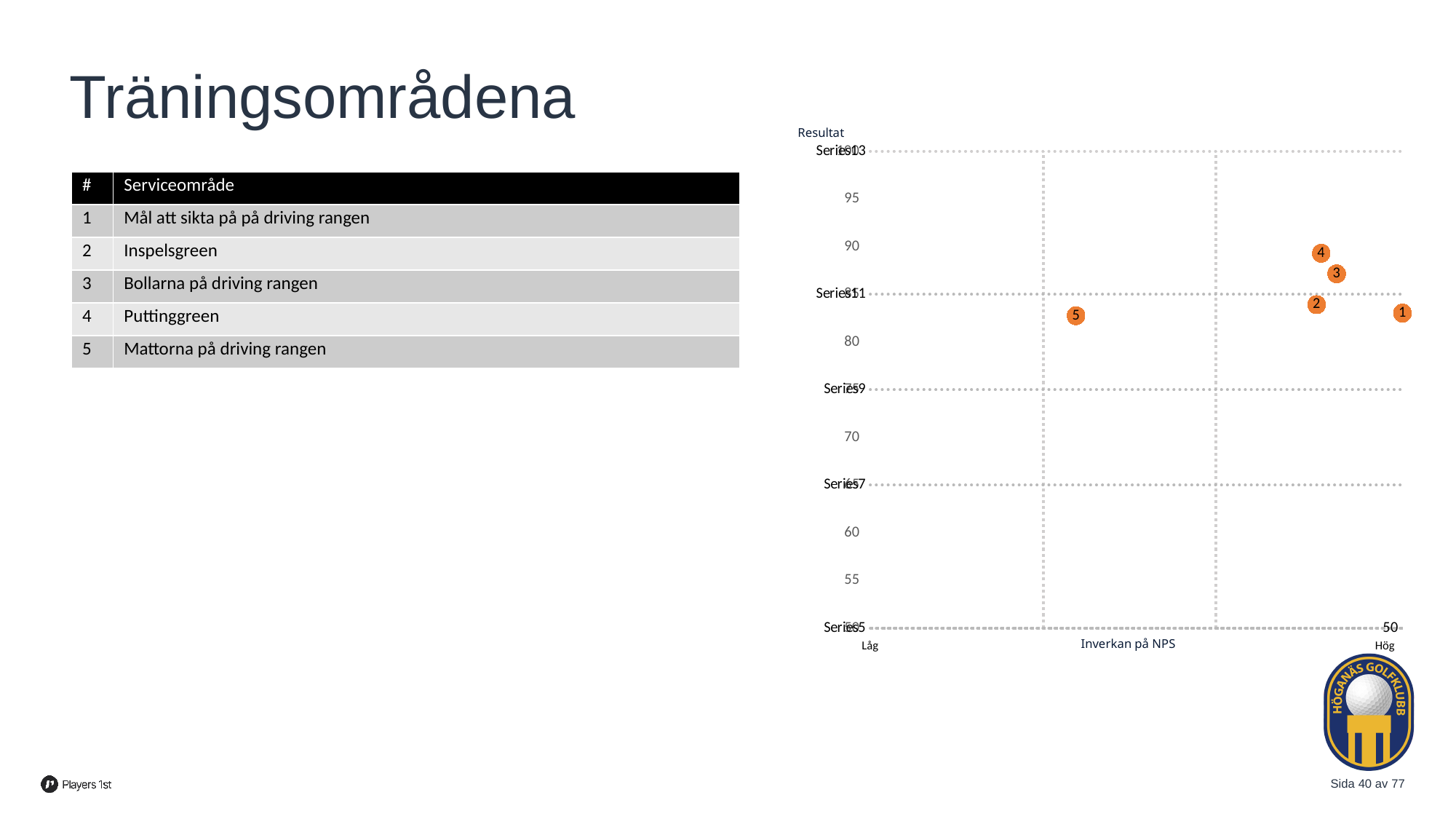
Is the Resultat value for point 1 greater or less than 90? less What is the title of the horizontal axis of the chart? Inverkan på NPS Which has a higher Resultat value, point 4 or point 5? point 4 Which point has the highest Resultat value in the chart? 4 Is the Resultat value for point 4 greater or less than 85? greater Is the Resultat value for point 3 greater or less than 85? greater How many data points are plotted in the chart? 5 Which point is furthest to the left on the Inverkan på NPS axis? 5 What is the title of the vertical axis of the chart? Resultat What kind of chart is shown on the slide? scatter chart Which point is furthest to the right on the Inverkan på NPS axis? 1